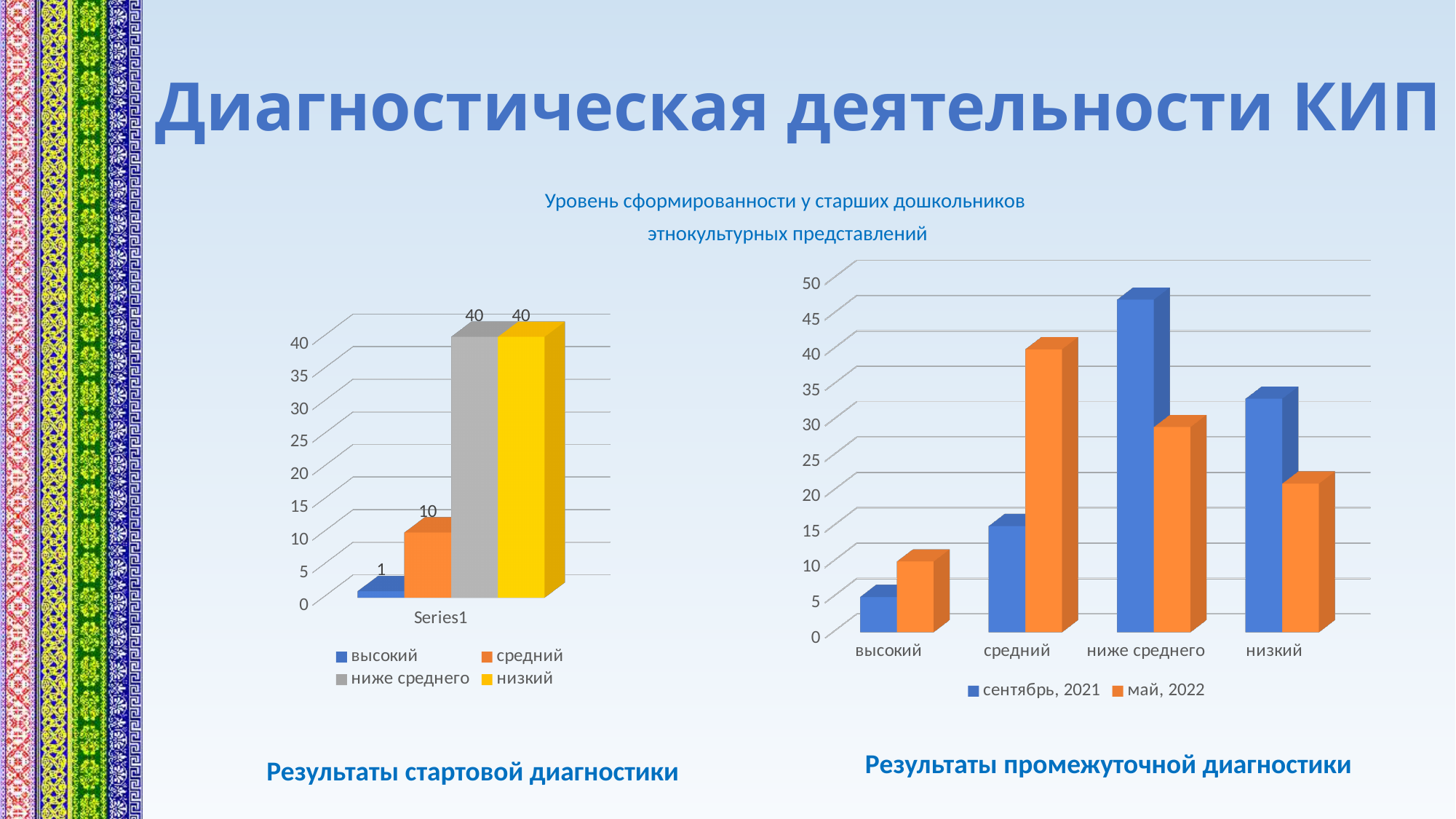
In the left chart (Результаты стартовой диагностики), how many entries does the legend list? 4 In the right chart (Результаты промежуточной диагностики), which category has the highest value for сентябрь, 2021? ниже среднего In the left chart (Результаты стартовой диагностики), what is the value for средний? 10 In the left chart (Результаты стартовой диагностики), which category has the lowest value? высокий In the left chart (Результаты стартовой диагностики), what is the value for высокий? 1 In the right chart (Результаты промежуточной диагностики), is the value for высокий in сентябрь, 2021 greater or less than 10? less In the left chart (Результаты стартовой диагностики), what is the difference between the values for ниже среднего and средний? 30 In the right chart (Результаты промежуточной диагностики), is the value for средний in май, 2022 greater or less than 35? greater What type of chart is the right chart (Результаты промежуточной диагностики)? bar chart In the right chart (Результаты промежуточной диагностики), how many categories are shown on the x axis? 4 In the right chart (Результаты промежуточной диагностики), how many series does the legend list? 2 In the left chart (Результаты стартовой диагностики), what is the value for низкий? 40